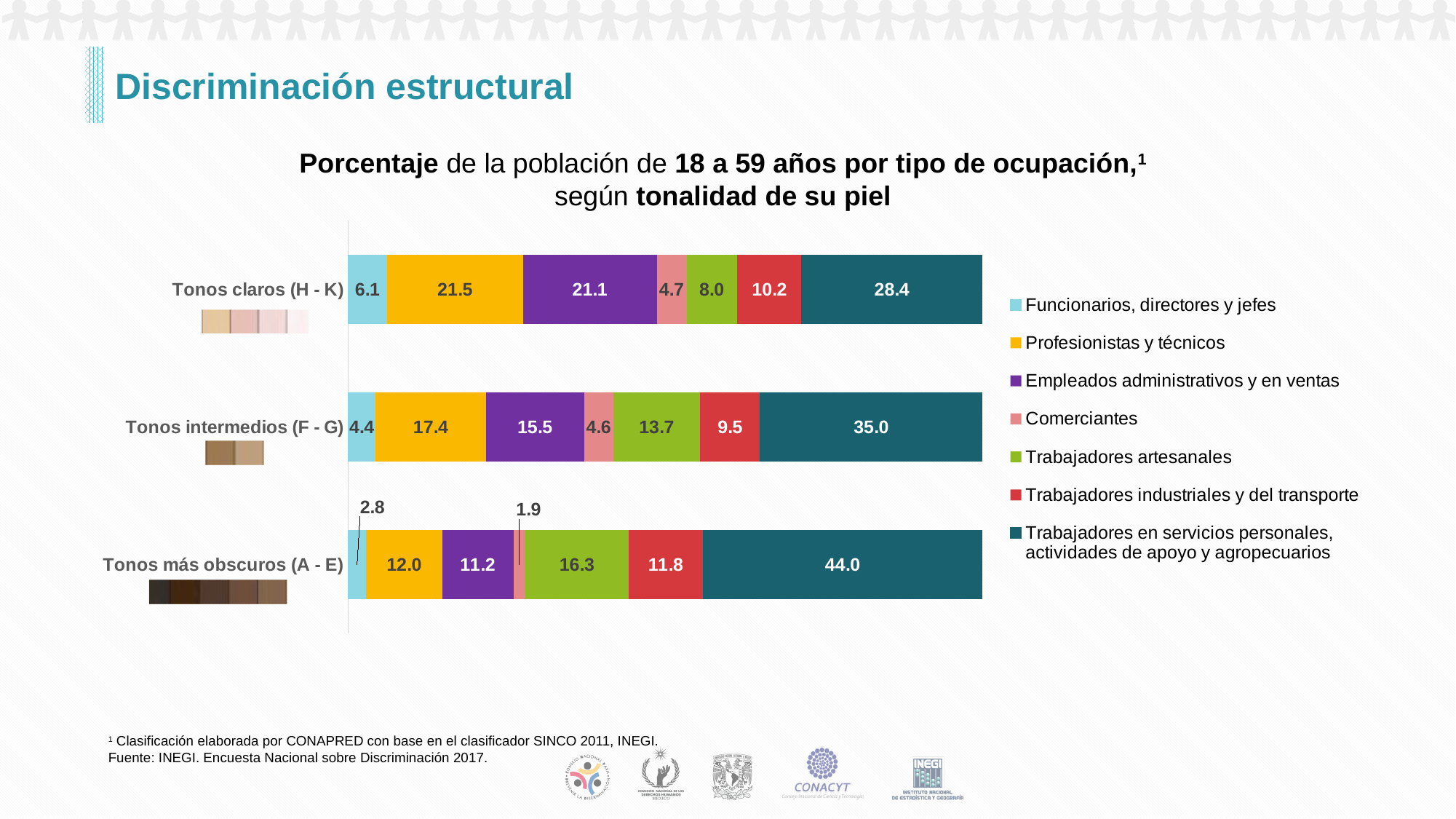
Which skin-tone category has the lowest value for Trabajadores en servicios personales, actividades de apoyo y agropecuarios? Tonos claros (H - K) What is the total of the Tonos claros (H - K) stacked bar? 100.0 Which is larger: Trabajadores artesanales for Tonos intermedios (F - G) or for Tonos claros (H - K)? Tonos intermedios (F - G) How many series does the legend list? 7 What is the value for Profesionistas y técnicos in the Tonos claros (H - K) bar? 21.5 Which skin-tone category has the highest value for Funcionarios, directores y jefes? Tonos claros (H - K) Which legend entry is shown in dark teal? Trabajadores en servicios personales, actividades de apoyo y agropecuarios How many skin-tone categories are plotted on the chart? 3 What is the difference between the Trabajadores en servicios personales value for Tonos más obscuros (A - E) and for Tonos claros (H - K)? 15.6 What is the value for Trabajadores en servicios personales, actividades de apoyo y agropecuarios in the Tonos más obscuros (A - E) bar? 44.0 What type of chart is shown on the slide? Stacked bar chart What is the value for Comerciantes in the Tonos intermedios (F - G) bar? 4.6